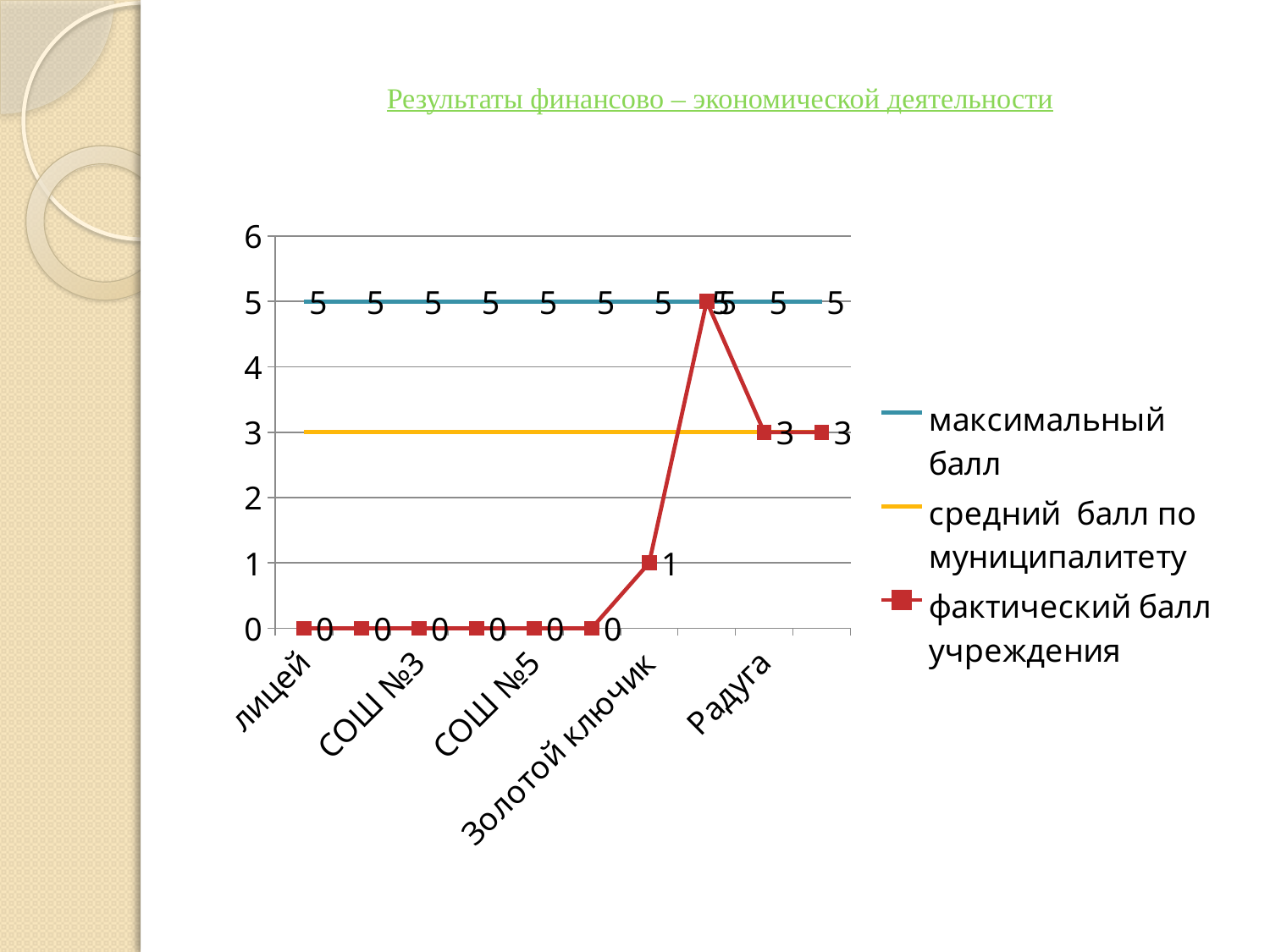
How many series does the legend list? 3 Is the средний балл по муниципалитету greater or less than 4? less What is the фактический балл учреждения for Золотой ключик? 1 What kind of chart is shown on the slide? line chart Does the фактический балл учреждения rise or fall from лицей to Радуга? rise How many data points are plotted on the фактический балл учреждения line? 10 What is the фактический балл учреждения for Радуга? 3 What is the difference between the максимальный балл and the фактический балл учреждения for Золотой ключик? 4 What is the фактический балл учреждения for лицей? 0 Which series is drawn with square markers? фактический балл учреждения What is the максимальный балл for СОШ №3? 5 Which has the higher фактический балл учреждения, Радуга or Золотой ключик? Радуга